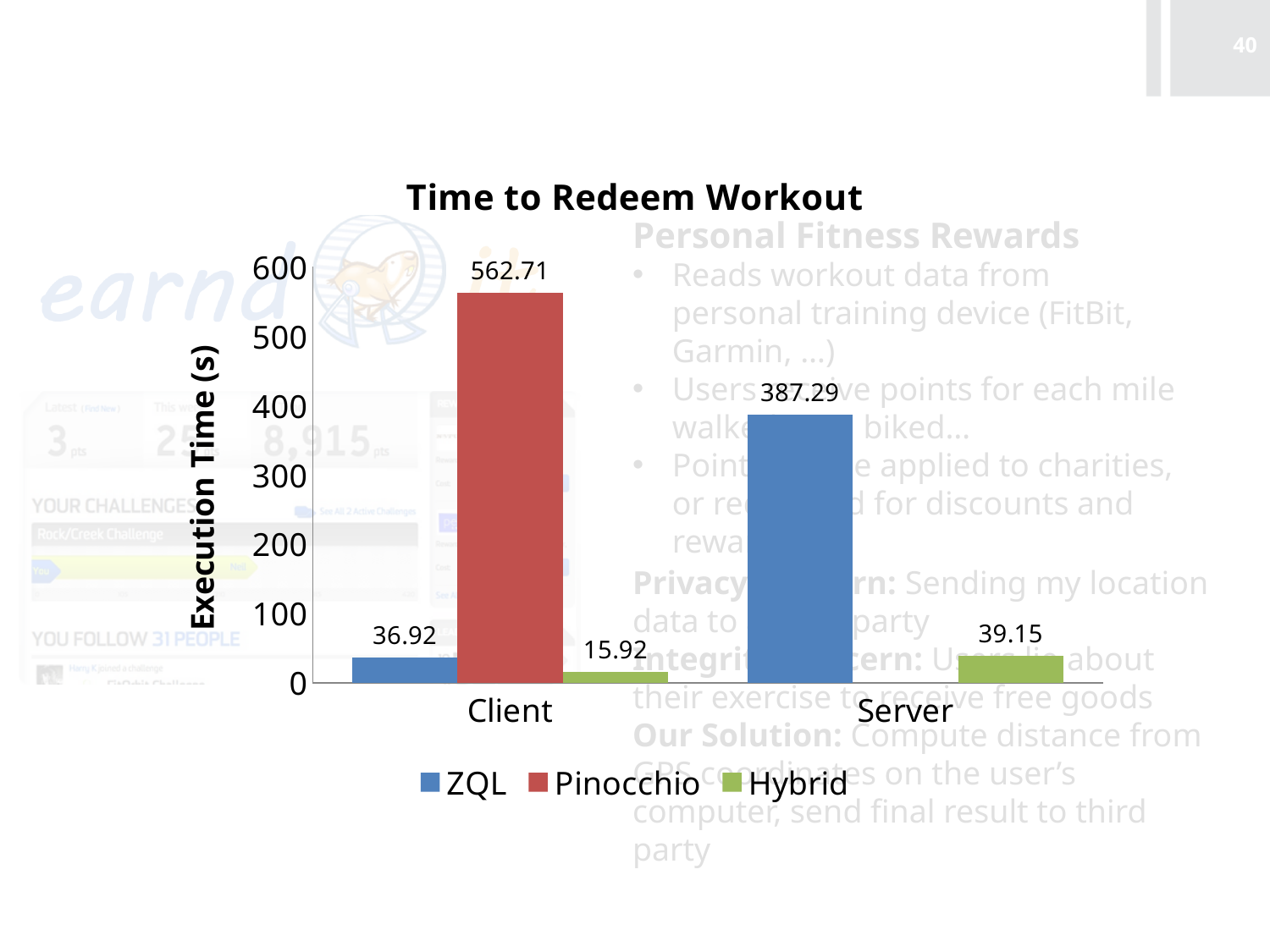
Which is larger, the Hybrid execution time for Client or for Server? Server How many categories are shown on the x axis? 2 What type of chart is shown? bar chart Which series has the lowest execution time for the Client category? Hybrid Is the ZQL execution time for the Client greater or less than 100? less What is the execution time for Hybrid on the Client? 15.92 What is the difference between the ZQL execution times for Server and Client? 350.37 Which series has the highest execution time for the Client category? Pinocchio What is the execution time for ZQL on the Server? 387.29 What is the execution time for Hybrid on the Server? 39.15 How many series does the legend list? 3 What is the execution time for Pinocchio on the Client? 562.71